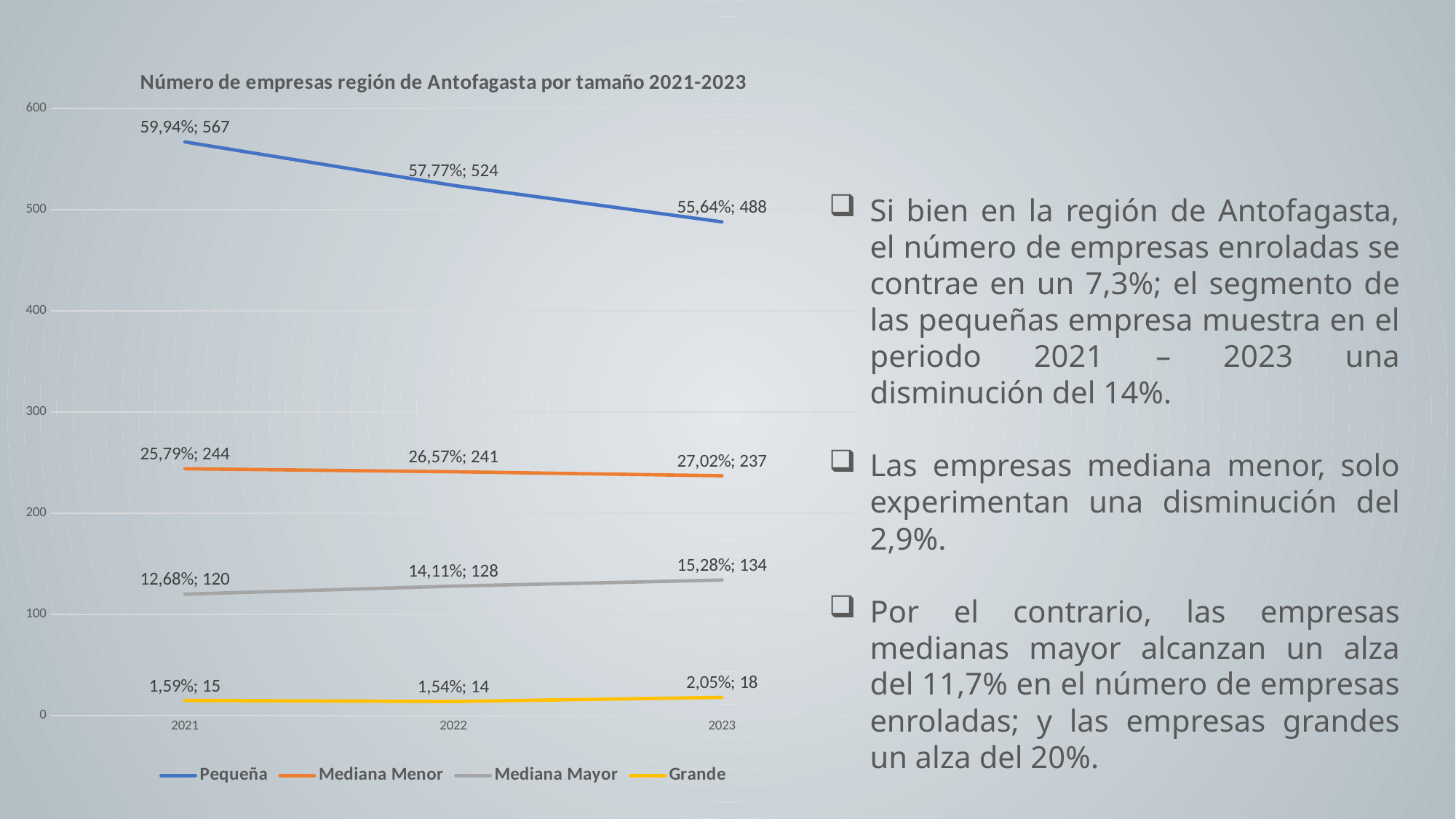
What type of chart is shown on the slide? line chart What is the title of the chart? Número de empresas región de Antofagasta por tamaño 2021-2023 Which series has the lowest value in 2021? Grande What is the difference between the Pequeña values in 2021 and 2023? 79 What is the number of Pequeña companies in 2021? 567 What percentage share is labelled for Grande in 2023? 2,05% What is the number of Mediana Mayor companies in 2023? 134 Which is larger, Mediana Menor in 2021 or Mediana Mayor in 2023? Mediana Menor in 2021 Does the Mediana Mayor series rise or fall from 2021 to 2023? rise How many series does the legend list? 4 How many years are shown on the x axis? 3 Which series has the highest value in 2022? Pequeña